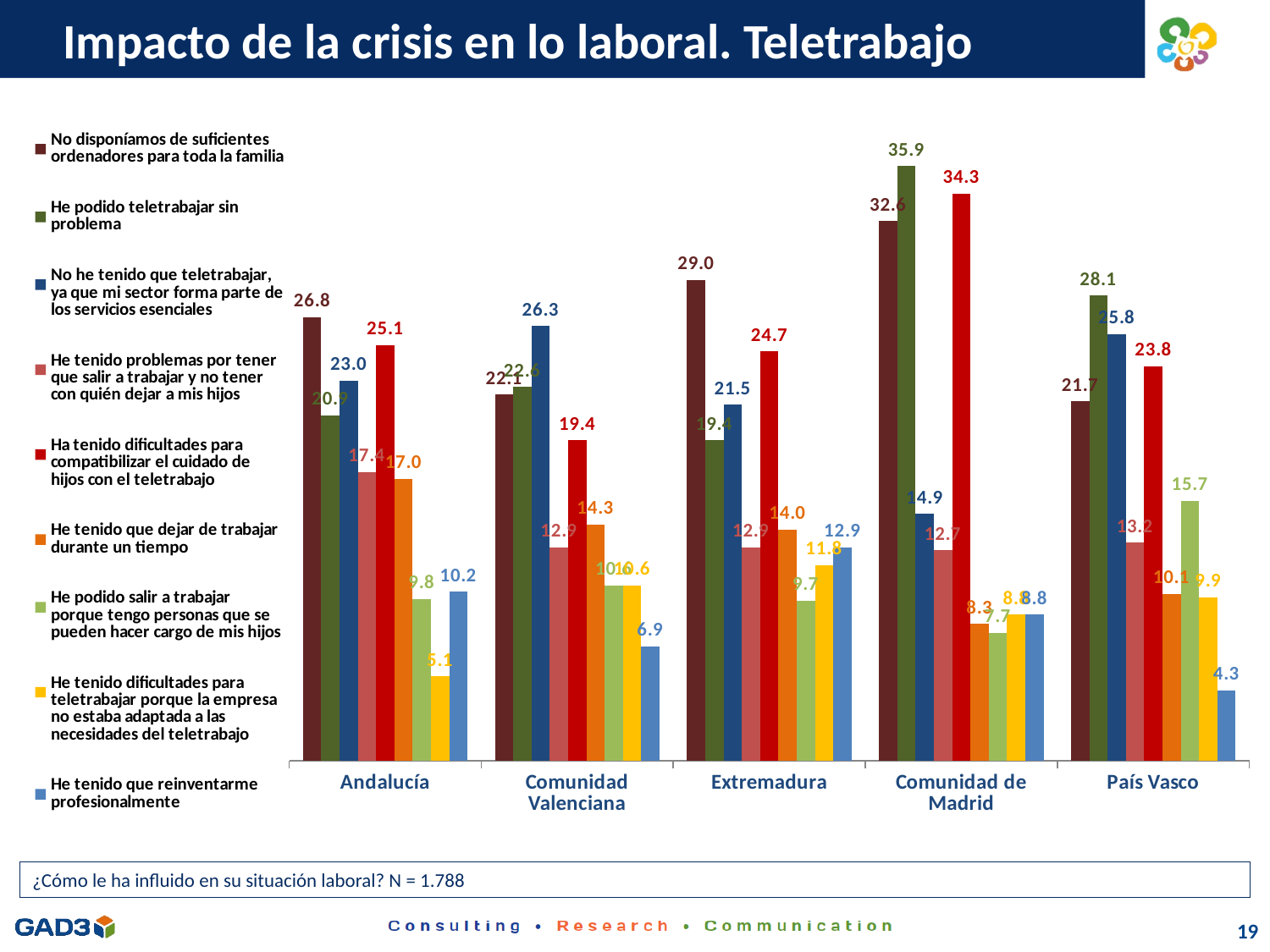
Which region has the highest value for 'Ha tenido dificultades para compatibilizar el cuidado de hijos con el teletrabajo'? Comunidad de Madrid What is the value for 'He podido teletrabajar sin problema' in Comunidad de Madrid? 35.9 Which is larger in Andalucía: 'No disponíamos de suficientes ordenadores para toda la familia' or 'Ha tenido dificultades para compatibilizar el cuidado de hijos con el teletrabajo'? No disponíamos de suficientes ordenadores para toda la familia What is the sample size (N) stated in the question box below the chart? 1.788 What is the value for 'No he tenido que teletrabajar, ya que mi sector forma parte de los servicios esenciales' in Comunidad Valenciana? 26.3 What is the difference between 'He podido teletrabajar sin problema' and 'No disponíamos de suficientes ordenadores para toda la familia' in Comunidad de Madrid? 3.3 How many series does the legend list? 9 What is the value for 'He tenido que reinventarme profesionalmente' in País Vasco? 4.3 Which region has the lowest value for 'He tenido que reinventarme profesionalmente'? País Vasco How many regions (categories) are shown on the x axis? 5 What kind of chart is shown on the slide? bar chart What is the value for 'No disponíamos de suficientes ordenadores para toda la familia' in Extremadura? 29.0